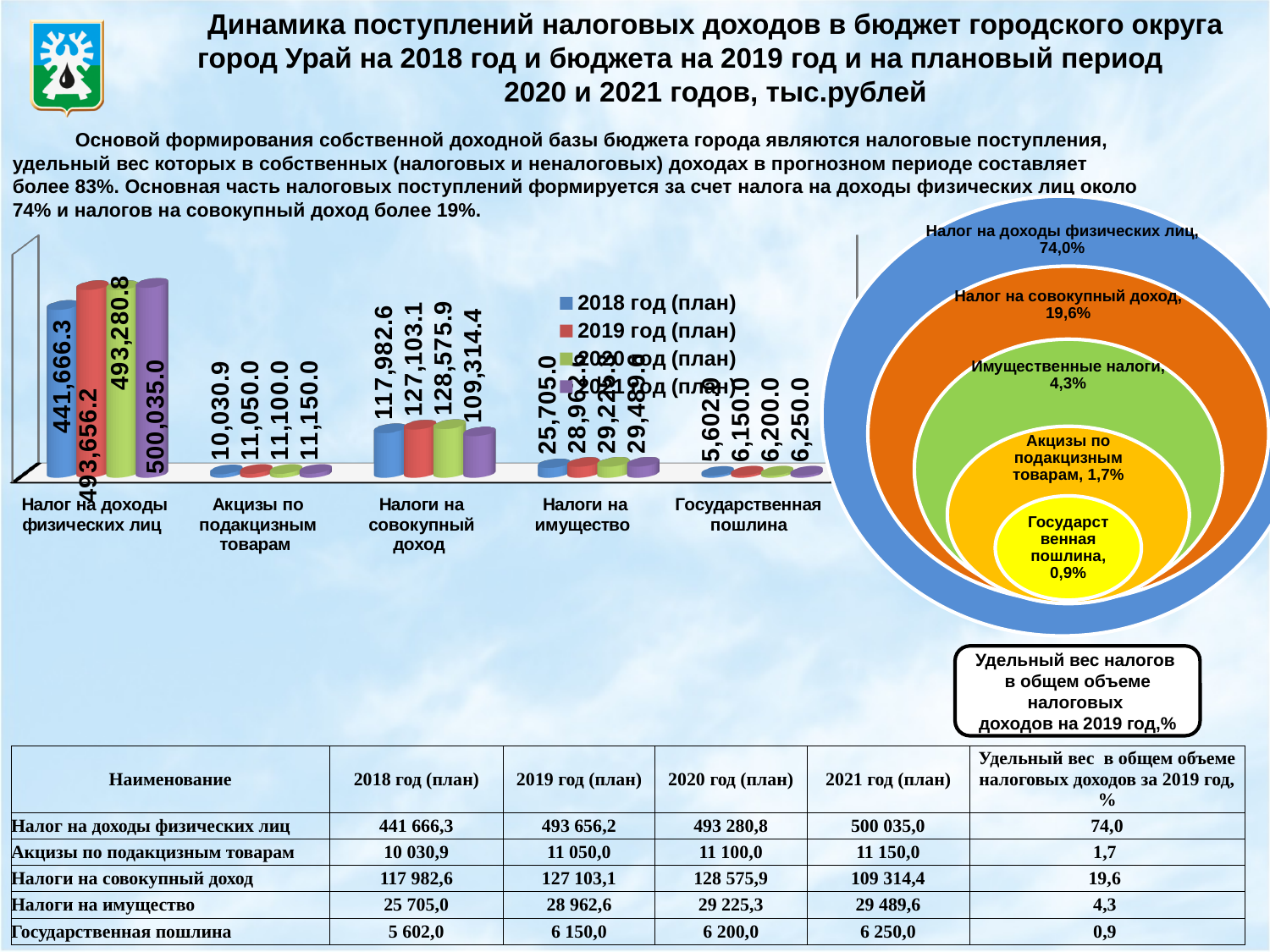
In the bar chart, what is the value for Налог на доходы физических лиц in the 2018 год (план) series? 441,666.3 In the bar chart, do the values for Государственная пошлина rise or fall from 2018 год (план) to 2021 год (план)? rise How many categories are shown on the x axis of the bar chart? 5 In the bar chart, which category has the highest value in the 2019 год (план) series? Налог на доходы физических лиц In the bar chart, what is the value for Налоги на совокупный доход in the 2021 год (план) series? 109,314.4 In the bar chart, for Налоги на совокупный доход, which is larger: the 2020 год (план) value or the 2021 год (план) value? 2020 год (план) What are the four entries listed in the legend of the bar chart? 2018 год (план), 2019 год (план), 2020 год (план), 2021 год (план) How many series does the legend of the bar chart list? 4 In the bar chart, what is the difference between the 2021 год (план) and 2018 год (план) values for Акцизы по подакцизным товарам? 1,119.1 In the bar chart, what is the value for Налоги на имущество in the 2019 год (план) series? 28,962.6 In the bar chart, which category has the lowest value in the 2018 год (план) series? Государственная пошлина What kind of chart is the chart on the left of the slide? bar chart